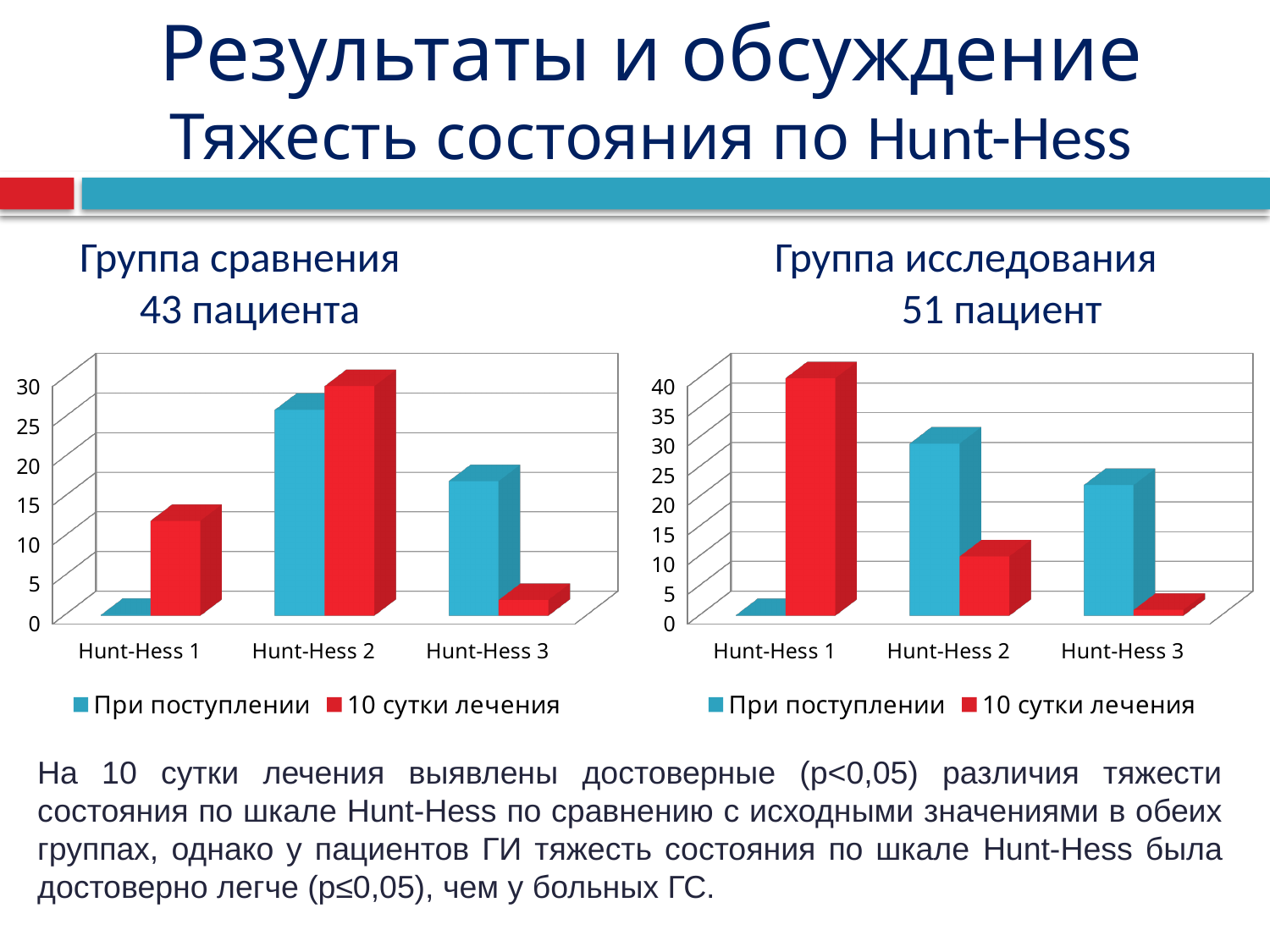
In the "Группа сравнения 43 пациента" chart, which series is shown in red? 10 сутки лечения What kind of chart is used for the "Группа сравнения 43 пациента" chart? bar chart In the "Группа сравнения 43 пациента" chart, which category has the lowest "10 сутки лечения" bar? Hunt-Hess 3 In the "Группа исследования 51 пациент" chart, is the "10 сутки лечения" value for Hunt-Hess 1 greater or less than 35? greater In the "Группа исследования 51 пациент" chart, for Hunt-Hess 2, which series has the larger value: "При поступлении" or "10 сутки лечения"? При поступлении In the "Группа сравнения 43 пациента" chart, for Hunt-Hess 3, which series has the larger value: "При поступлении" or "10 сутки лечения"? При поступлении In the "Группа исследования 51 пациент" chart, which category has the highest "При поступлении" bar? Hunt-Hess 2 How many categories are shown on the x axis of the "Группа сравнения 43 пациента" chart? 3 How many series does the legend of the "Группа исследования 51 пациент" chart list? 2 In the "Группа сравнения 43 пациента" chart, which category has the highest "При поступлении" bar? Hunt-Hess 2 In the "Группа сравнения 43 пациента" chart, is the "При поступлении" value for Hunt-Hess 2 greater or less than 20? greater In the "Группа исследования 51 пациент" chart, which category has the highest "10 сутки лечения" bar? Hunt-Hess 1